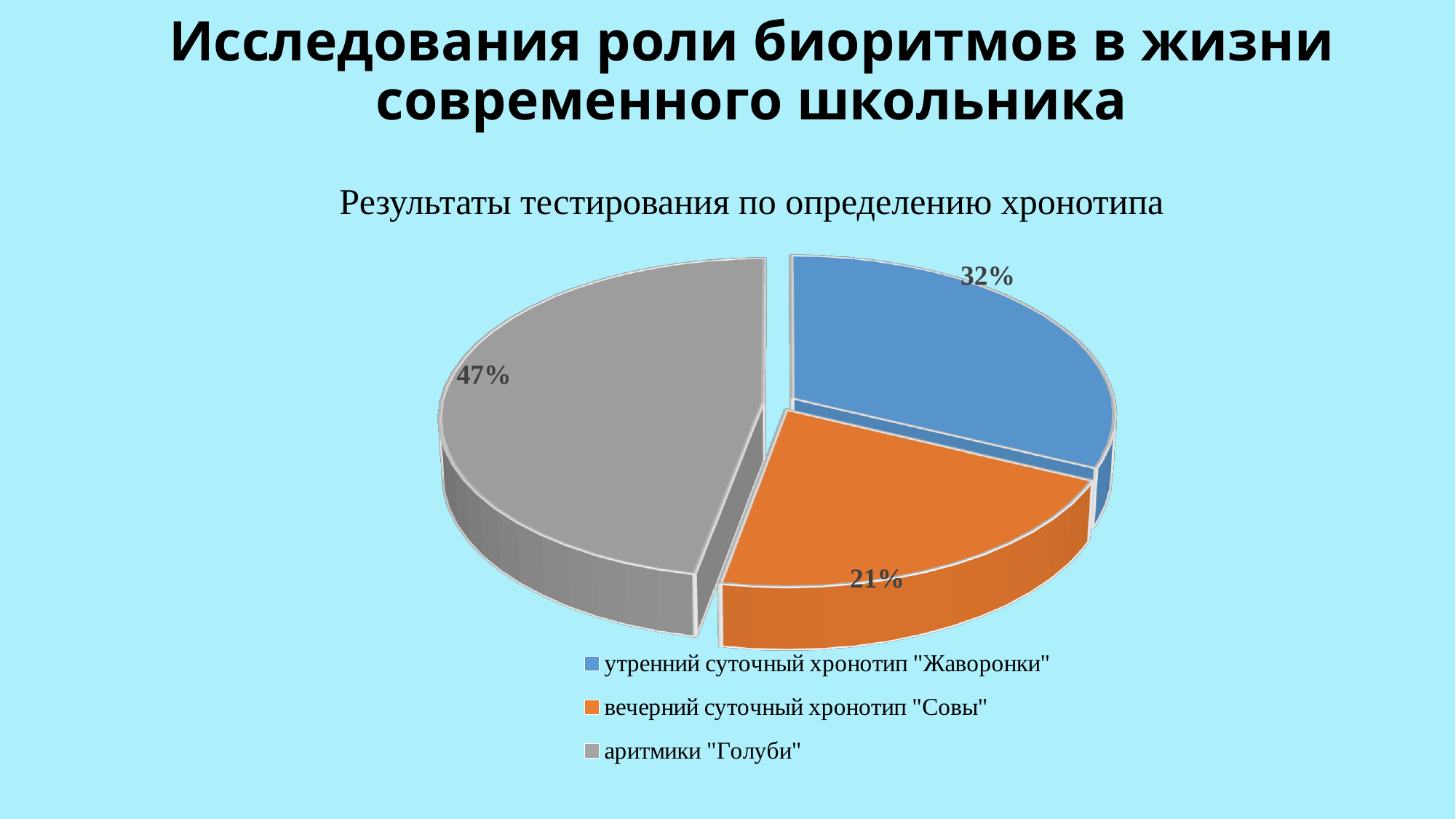
What is the chart's title? Результаты тестирования по определению хронотипа What colour is the slice for аритмики "Голуби"? grey Which category has the largest slice of the pie? аритмики "Голуби" What share of the pie is labelled for аритмики "Голуби"? 47% Which category has the smallest slice of the pie? вечерний суточный хронотип "Совы" What share of the pie is labelled for вечерний суточный хронотип "Совы"? 21% What is the difference in percentage points between утренний суточный хронотип "Жаворонки" and вечерний суточный хронотип "Совы"? 11% What is the difference in percentage points between аритмики "Голуби" and утренний суточный хронотип "Жаворонки"? 15% What share of the pie is labelled for утренний суточный хронотип "Жаворонки"? 32% What kind of chart is shown on the slide? pie chart How many slices does the pie chart have? 3 Which is larger: the slice for "Жаворонки" or the slice for "Совы"? "Жаворонки"